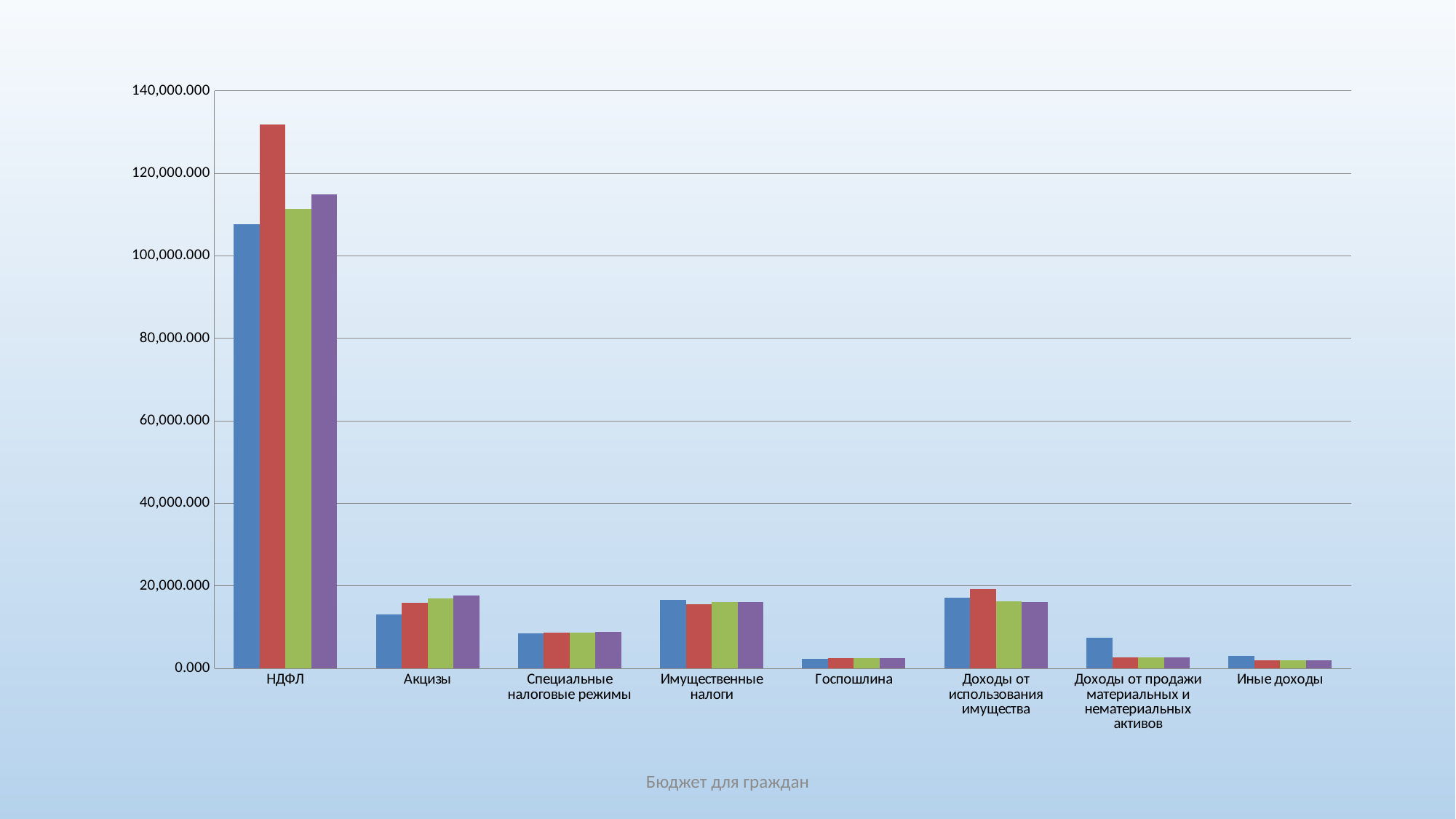
Which category has larger values, НДФЛ or Акцизы? НДФЛ What text appears below the chart on the slide? Бюджет для граждан Is the value of the blue bar for Акцизы greater or less than 20,000.000? less Is the value of the red bar for НДФЛ greater or less than 120,000.000? greater What kind of chart is shown on the slide? bar chart For Доходы от продажи материальных и нематериальных активов, which bar is larger, the blue one or the red one? the blue one How many bars are plotted for each category in the chart? 4 Is the value of the blue bar for НДФЛ greater or less than 100,000.000? greater How many categories are shown along the x axis of the chart? 8 Which category has the highest values in the chart? НДФЛ Which colour is the tallest bar in the НДФЛ group? red